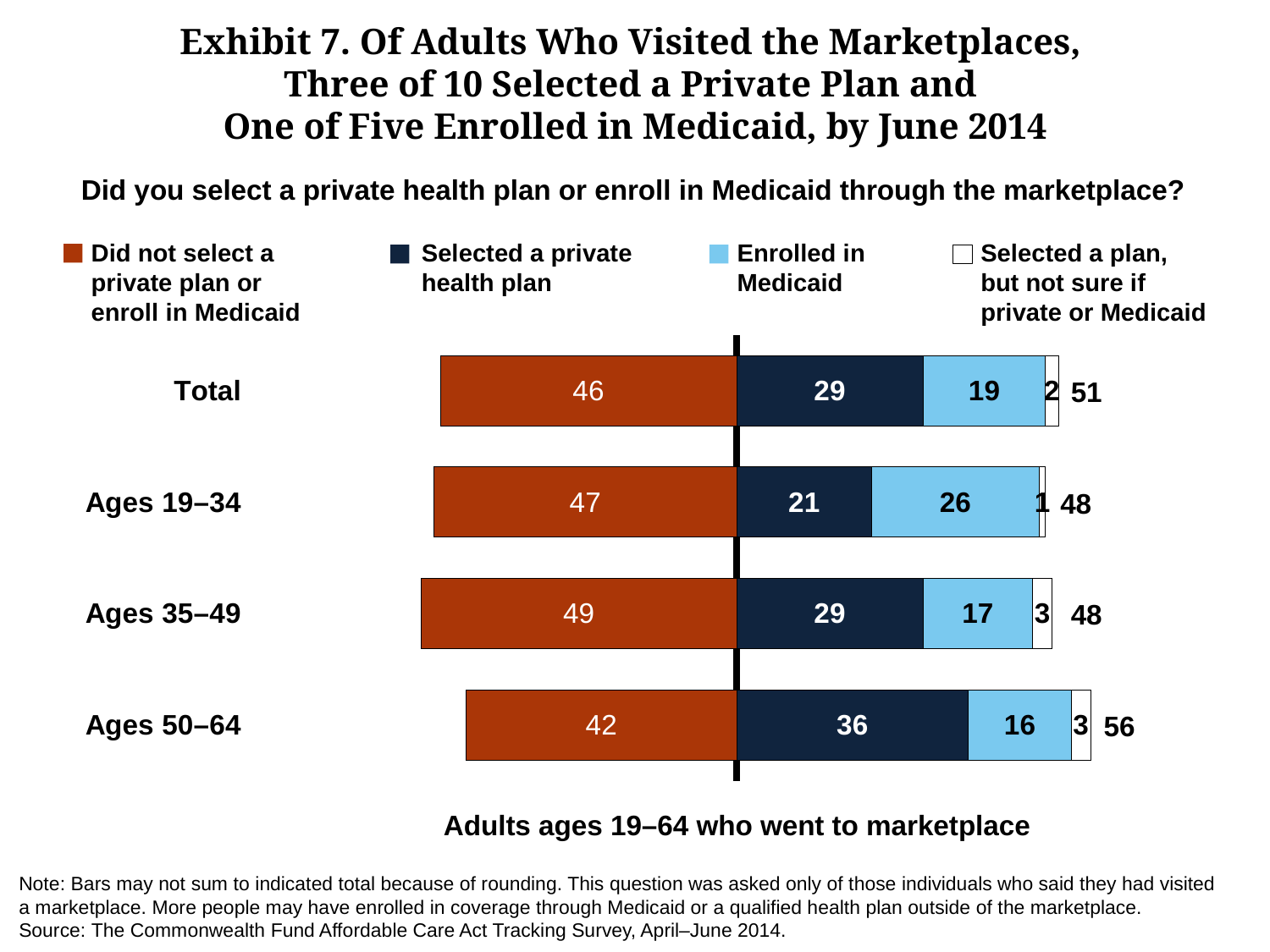
How many series does the legend list? 4 Which legend entry is shown in white (unfilled)? Selected a plan, but not sure if private or Medicaid What kind of chart is shown on the slide? Stacked bar chart What is the value for 'Enrolled in Medicaid' among adults ages 19–34? 26 Which is larger: the 'Enrolled in Medicaid' value for Ages 19–34 or for Ages 35–49? Ages 19–34 What total is printed at the end of the bar for Ages 50–64? 56 Which age group has the highest value for 'Selected a private health plan'? Ages 50–64 What is the value for 'Did not select a private plan or enroll in Medicaid' for the Total group? 46 What percentage of adults ages 50–64 selected a private health plan? 36 How many age groups (including Total) are plotted in the chart? 4 What is the difference between the 'Did not select a private plan or enroll in Medicaid' values for Ages 35–49 and Ages 50–64? 7 Which age group has the lowest value for 'Enrolled in Medicaid'? Ages 50–64